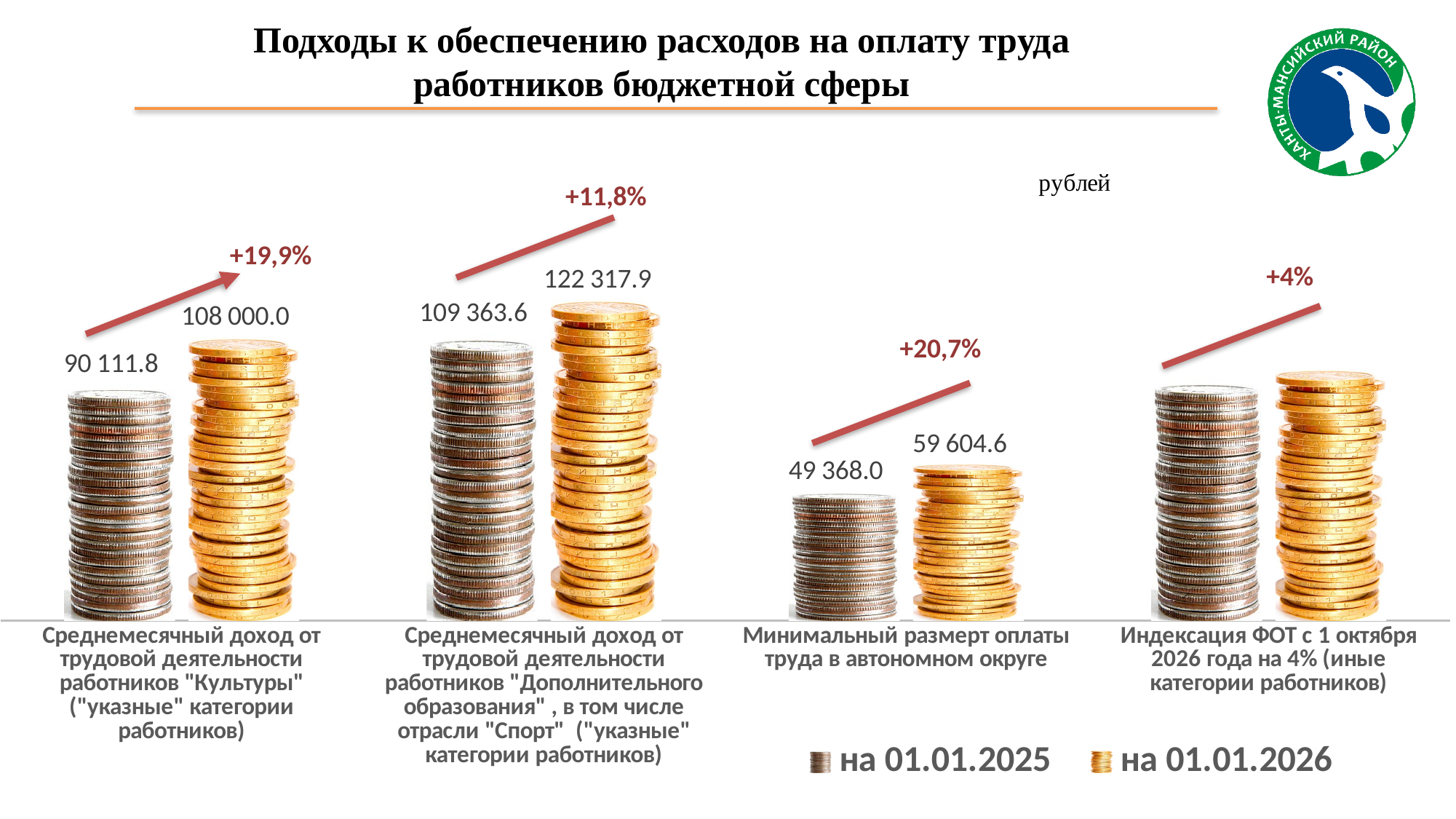
How many series does the legend list? 2 What is the value for 'на 01.01.2026' in the category 'Минимальный размерт оплаты труда в автономном округе'? 59 604.6 What is the value for 'на 01.01.2025' in the category 'Среднемесячный доход от трудовой деятельности работников "Культуры"'? 90 111.8 Which category has the lowest value for 'на 01.01.2025'? Минимальный размерт оплаты труда в автономном округе What is the difference between the 'на 01.01.2026' and 'на 01.01.2025' values in the category 'Среднемесячный доход от трудовой деятельности работников "Культуры"'? 17 888.2 What percentage increase is shown above the category 'Минимальный размерт оплаты труда в автономном округе'? +20,7% What unit is indicated for the values on the chart? рублей Which is larger: the 'на 01.01.2025' value for 'Дополнительного образования' or the 'на 01.01.2026' value for 'Культуры'? на 01.01.2025 value for "Дополнительного образования" (109 363.6) Which category has the highest value for 'на 01.01.2026' among those with printed values? Среднемесячный доход от трудовой деятельности работников "Дополнительного образования" What is the value for 'на 01.01.2025' in the category 'Среднемесячный доход от трудовой деятельности работников "Дополнительного образования"'? 109 363.6 What is the value for 'на 01.01.2026' in the category 'Среднемесячный доход от трудовой деятельности работников "Культуры"'? 108 000.0 What percentage increase is shown above the category 'Среднемесячный доход от трудовой деятельности работников "Дополнительного образования"'? +11,8%